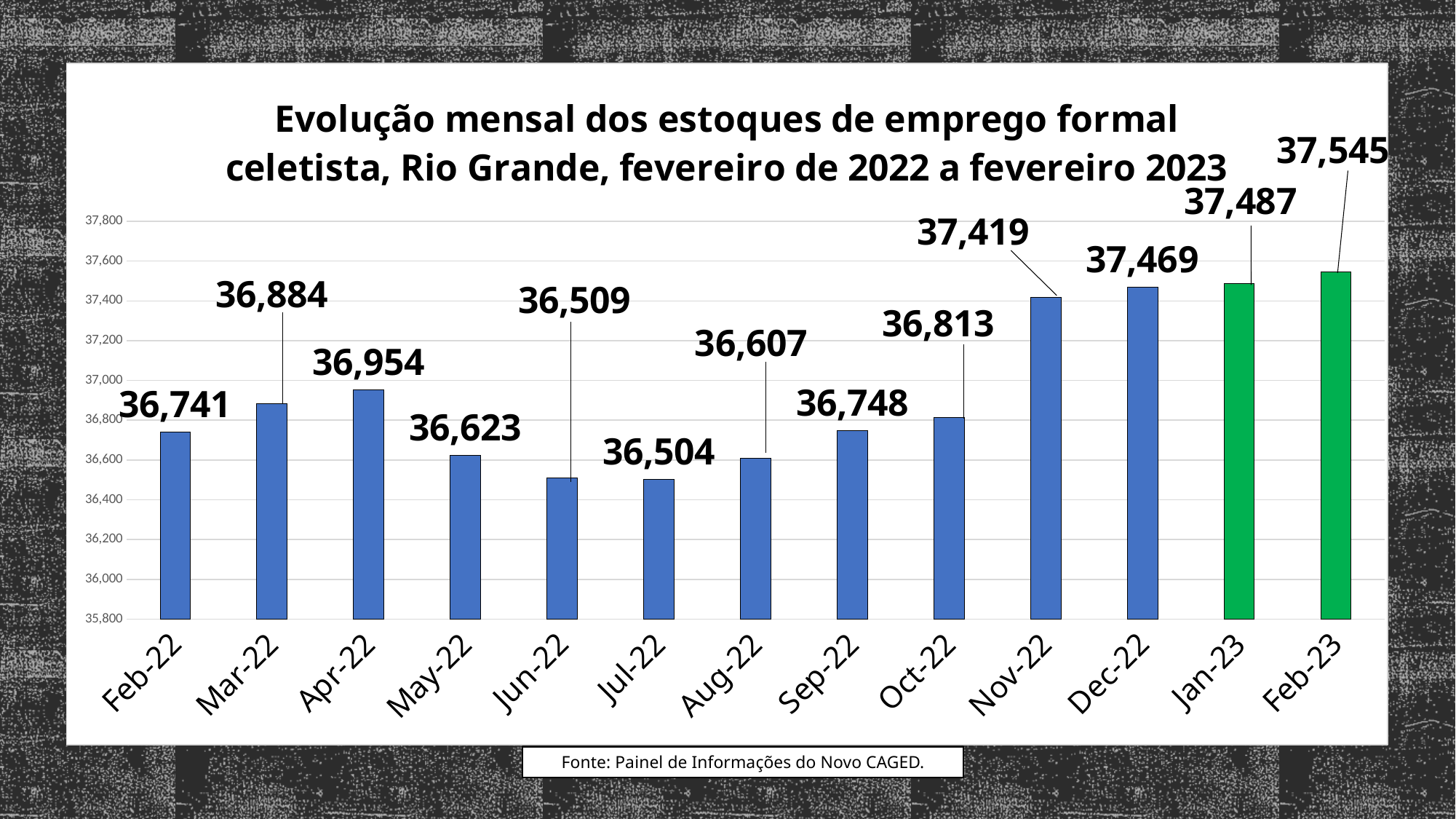
Which is larger, the value for Apr-22 or the value for Sep-22? Apr-22 Is the value for Dec-22 greater or less than 37,200? greater What is the difference between the values for Nov-22 and Oct-22? 606 What is the value for Jul-22? 36,504 How many months are shown on the x axis? 13 What is the difference between the values for Feb-23 and Feb-22? 804 What is the value for Feb-22? 36,741 What colour are the bars for Jan-23 and Feb-23? Green What kind of chart is shown on the slide? Bar chart What is the value for Nov-22? 37,419 Which month has the lowest value? Jul-22 Which month has the highest value? Feb-23